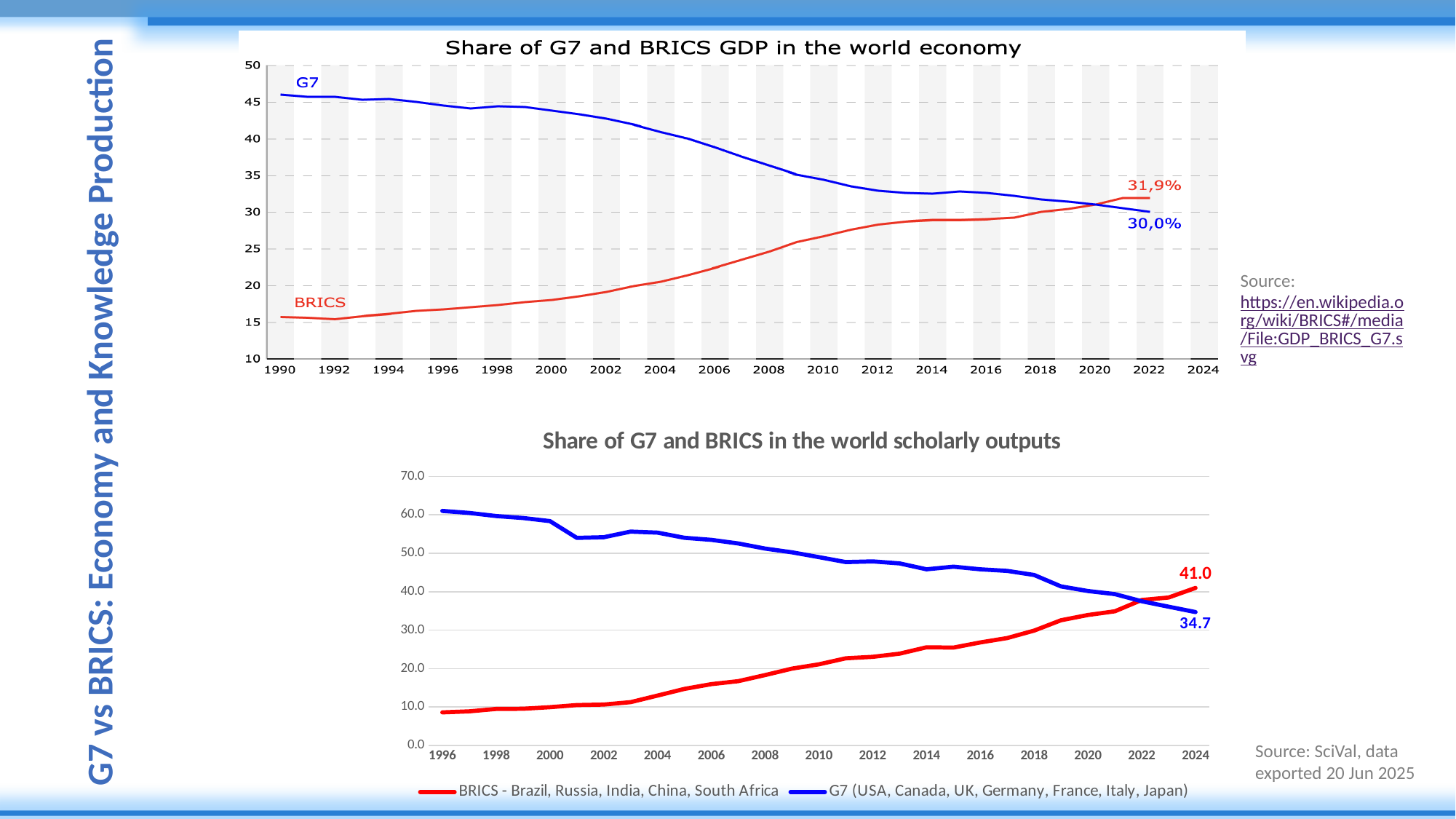
How many series does the legend of the bottom chart (scholarly outputs) list? 2 In the top chart (GDP share), is the G7 value in 1990 greater or less than 45? greater In the top chart (GDP share), does the BRICS line rise or fall from 1990 to 2022? rise In the top chart (GDP share), is the BRICS value in 1990 greater or less than 20? less In the bottom chart (scholarly outputs), is the G7 value in 1996 greater or less than 50.0? greater In the bottom chart (scholarly outputs), what is the difference between the BRICS and G7 values in 2024? 6.3 In the top chart (GDP share), does the G7 line rise or fall from 1990 to 2022? fall In the top chart (GDP share), what is the final labelled value for BRICS? 31,9% What kind of chart is the top chart, 'Share of G7 and BRICS GDP in the world economy'? line chart In the bottom chart (scholarly outputs), what is the labelled value for BRICS in 2024? 41.0 In the top chart (GDP share), what is the final labelled value for G7? 30,0% In the bottom chart (scholarly outputs), what is the labelled value for G7 in 2024? 34.7